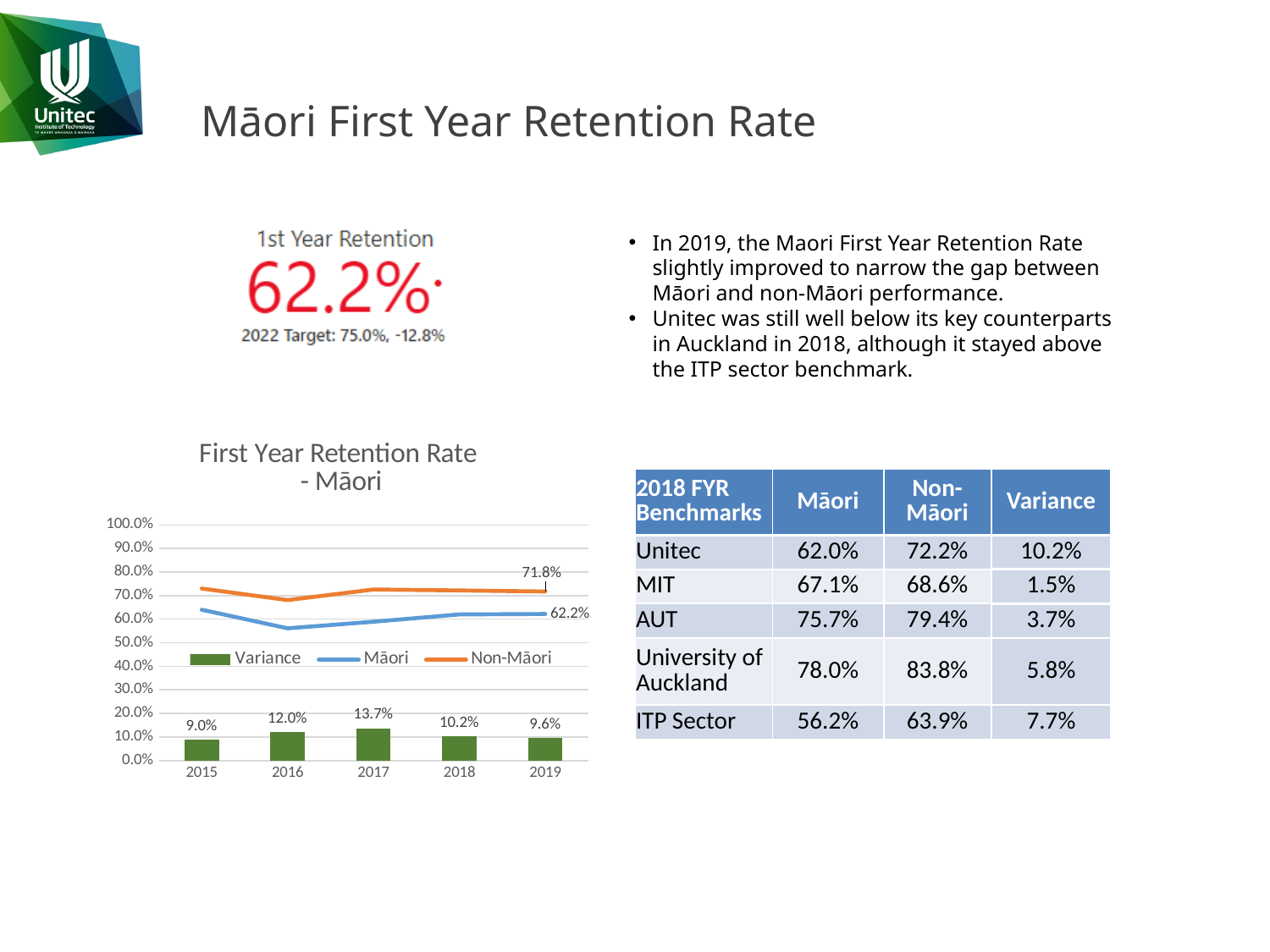
In the First Year Retention Rate - Māori chart, which year has the lowest Variance? 2015 How many years are shown on the x axis of the First Year Retention Rate - Māori chart? 5 In the First Year Retention Rate - Māori chart, what is the Variance value for 2015? 9.0% In the First Year Retention Rate - Māori chart, how much higher is the Non-Māori rate than the Māori rate in 2019? 9.6% In the First Year Retention Rate - Māori chart, what is the Māori retention rate in 2019? 62.2% In the First Year Retention Rate - Māori chart, what is the Non-Māori retention rate in 2019? 71.8% In the First Year Retention Rate - Māori chart, what is the Variance value for 2017? 13.7% In the First Year Retention Rate - Māori chart, does the Variance rise or fall from 2017 to 2019? fall In the First Year Retention Rate - Māori chart, which year has the highest Variance? 2017 In the First Year Retention Rate - Māori chart, is the Māori value for 2016 greater or less than 60.0%? less In the First Year Retention Rate - Māori chart, what is the difference between the Variance in 2017 and the Variance in 2015? 4.7% How many series does the legend of the First Year Retention Rate - Māori chart list? 3